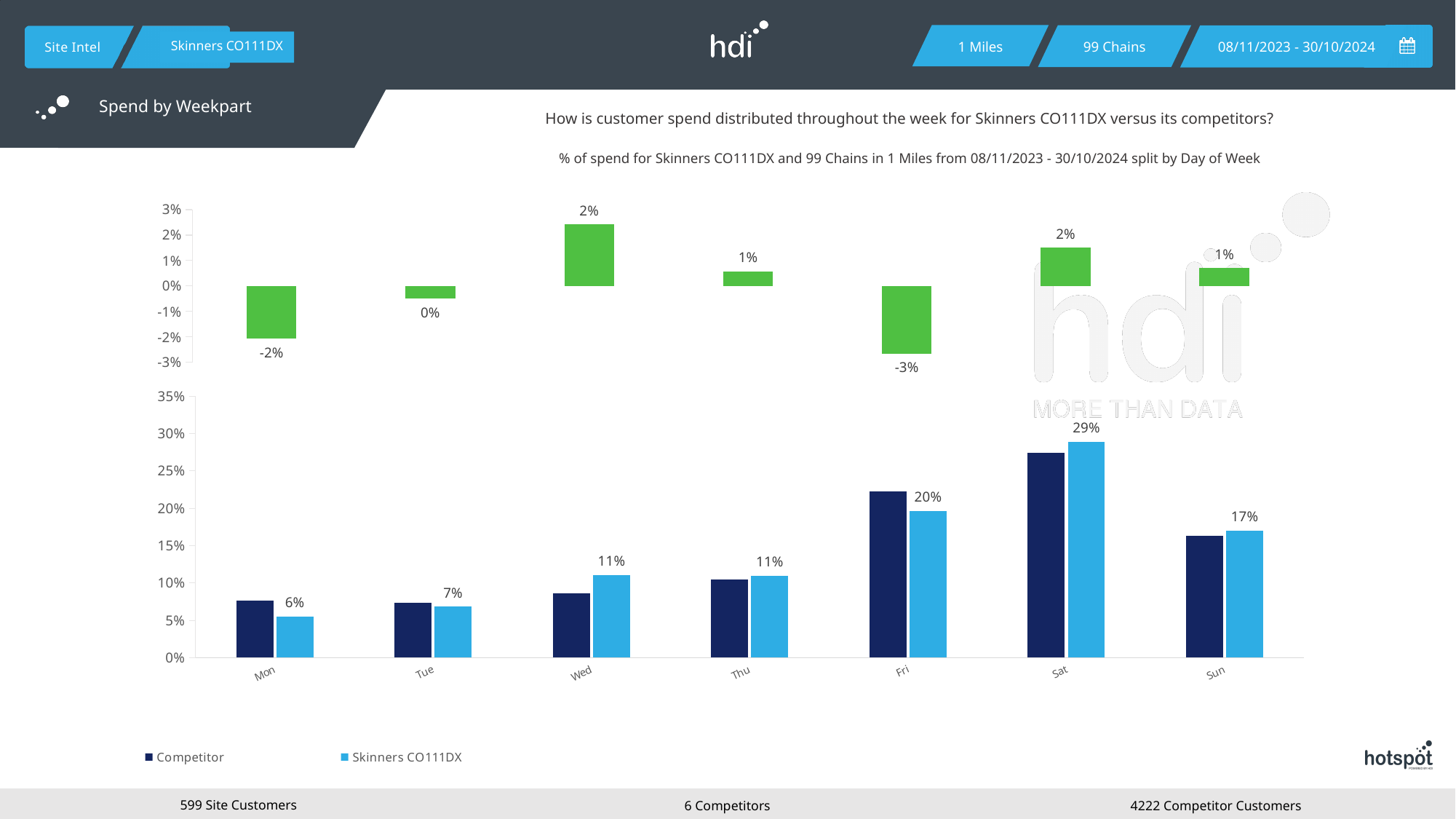
In the top chart, what is the value shown for Fri? -3% In the bottom bar chart, which is larger on Fri: the Competitor bar or the Skinners CO111DX bar? Competitor How many series does the legend of the bottom bar chart list? 2 In the bottom bar chart, what is the value for Skinners CO111DX on Mon? 6% In the bottom bar chart, is the Competitor value for Sat greater or less than 25%? greater In the top chart, which day has the lowest value? Fri In the bottom bar chart, is the Competitor value for Mon greater or less than 10%? less How many days of the week are shown on the x axis of the bottom bar chart? 7 In the bottom bar chart, which day has the lowest value for Skinners CO111DX? Mon In the bottom bar chart, what is the value for Skinners CO111DX on Sat? 29% In the bottom bar chart, which day has the highest value for Skinners CO111DX? Sat In the bottom bar chart, what is the difference between the Skinners CO111DX values for Sat and Fri? 9%